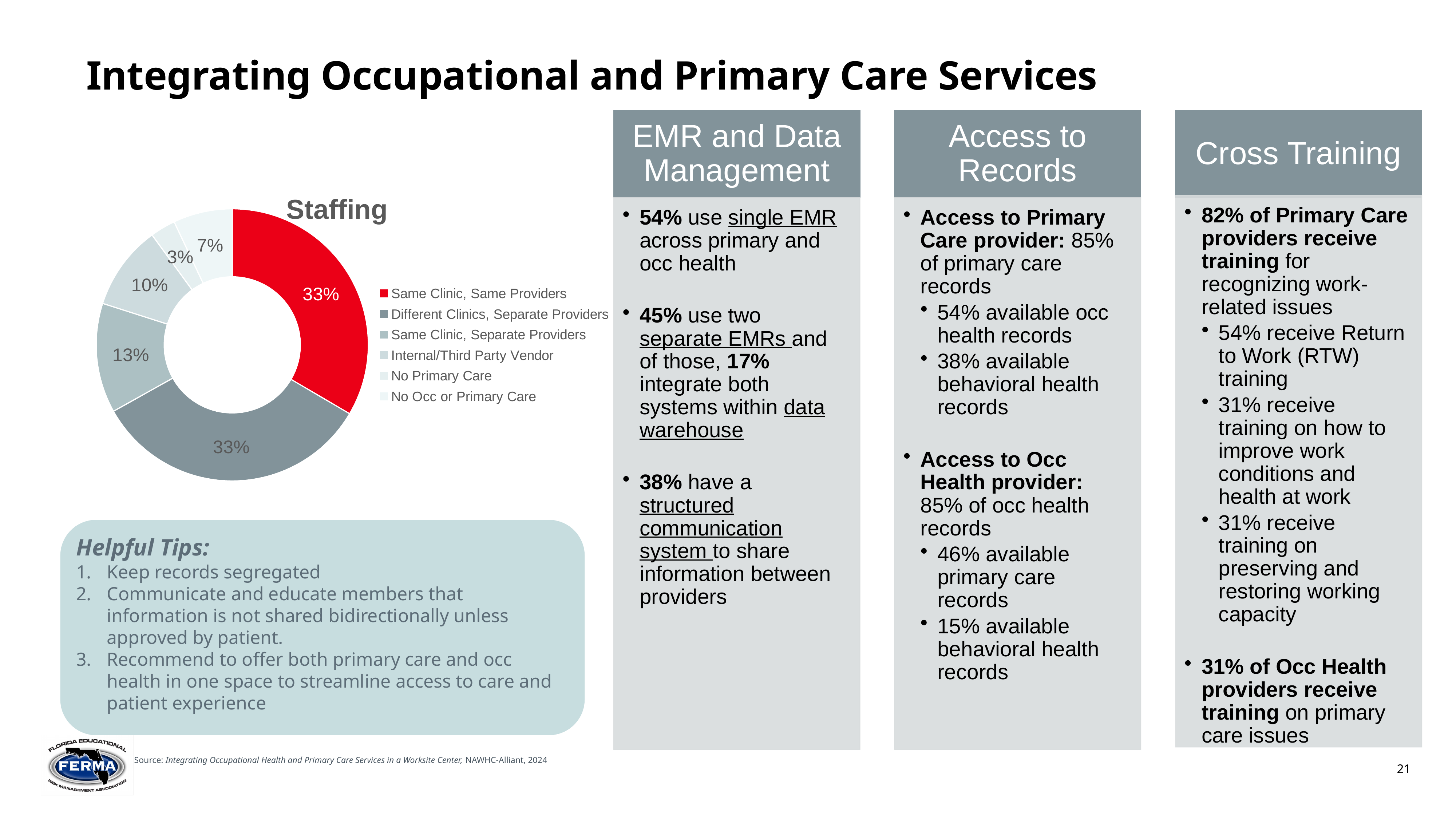
In the Staffing chart, what percentage is shown for Same Clinic, Separate Providers? 13% How many categories does the Staffing chart show? 6 In the Staffing chart, which is larger: Same Clinic, Separate Providers or Internal/Third Party Vendor? Same Clinic, Separate Providers In the Staffing chart, what percentage is shown for No Occ or Primary Care? 7% In the Staffing chart, what is the difference between Same Clinic, Separate Providers and Internal/Third Party Vendor? 3% What is the title of the pie chart on the slide? Staffing Which category in the Staffing chart is shown in red? Same Clinic, Same Providers In the Staffing chart, what percentage is shown for No Primary Care? 3% In the Staffing chart, what percentage is shown for Internal/Third Party Vendor? 10% In the Staffing chart, what percentage is shown for Same Clinic, Same Providers? 33% What kind of chart is the Staffing chart? Pie (donut) chart Which category has the smallest share in the Staffing chart? No Primary Care